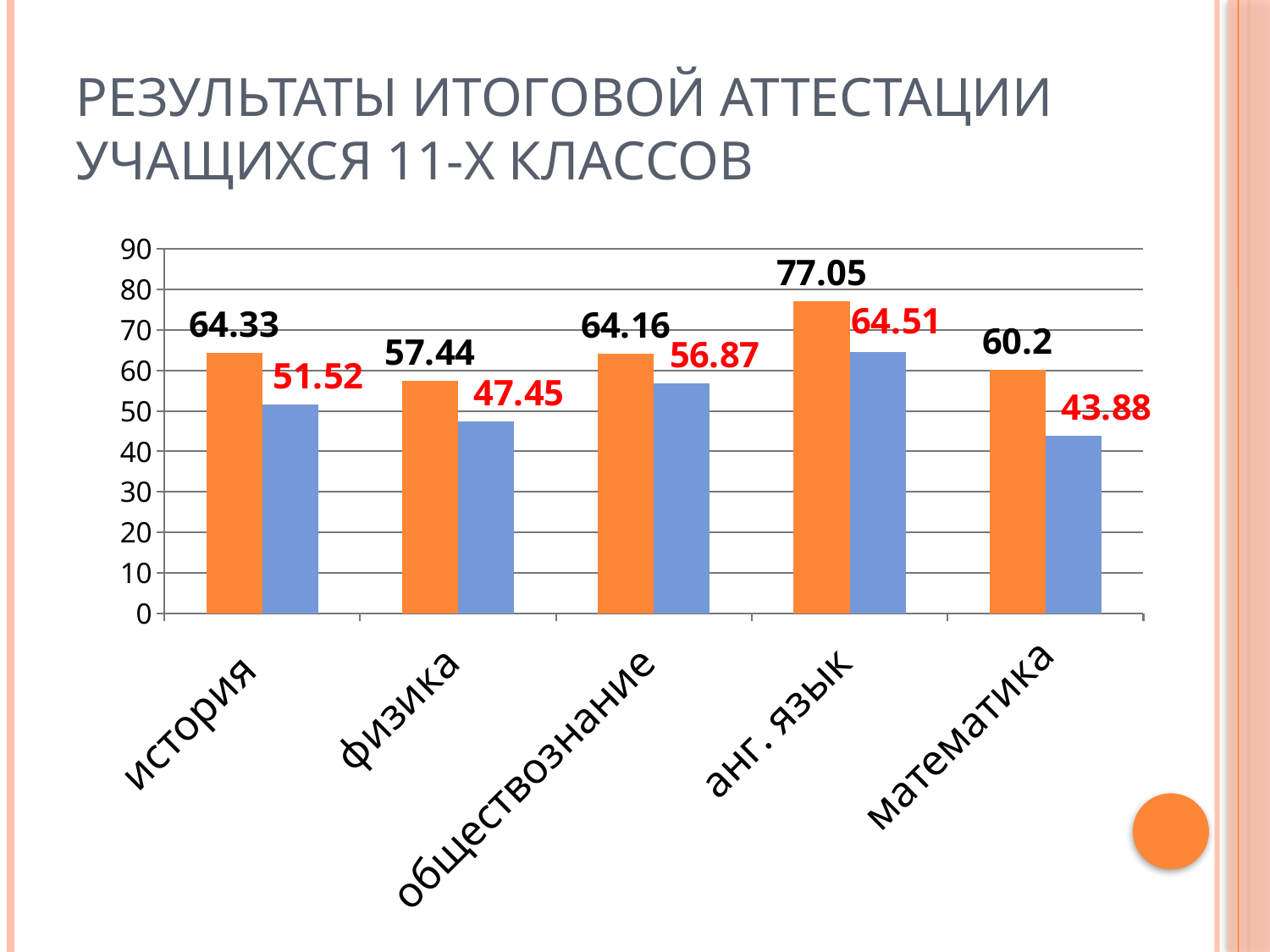
Which is larger, the blue bar for обществознание or the blue bar for история? обществознание Which category has the lowest blue bar? математика What is the value of the blue bar for физика? 47.45 What is the difference between the orange bars for анг. язык and физика? 19.61 What is the value of the orange bar for анг. язык? 77.05 Which category has the highest orange bar? анг. язык What kind of chart is shown on the slide? bar chart How many categories are shown on the x axis? 5 What is the value of the orange bar for история? 64.33 What is the title of the slide? Результаты итоговой аттестации учащихся 11-х классов What is the difference between the orange and blue bars for математика? 16.32 What is the value of the blue bar for математика? 43.88